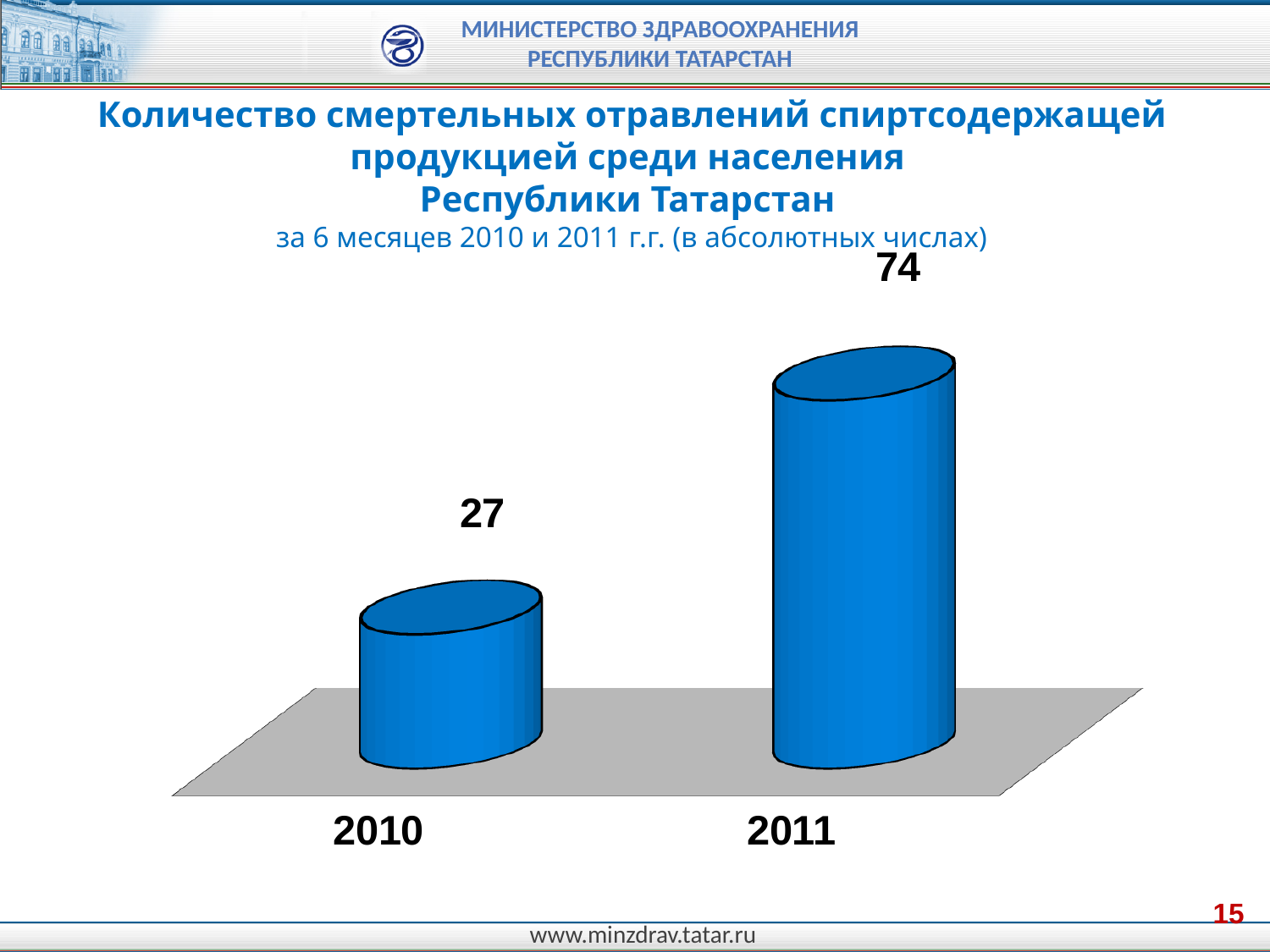
What period does the chart's subtitle say the data covers? за 6 месяцев 2010 и 2011 г.г. (в абсолютных числах) What colour are the bars in the chart? Blue What is the value for 2010? 27 What is the value for 2011? 74 Which is larger, the value for 2010 or the value for 2011? 2011 What kind of chart is shown on the slide? Bar chart What is the total of the values for 2010 and 2011? 101 What is the difference between the values for 2011 and 2010? 47 Which year has the lowest value? 2010 How many categories are shown in the chart? 2 Which year has the highest value? 2011 Do the values rise or fall from 2010 to 2011? Rise